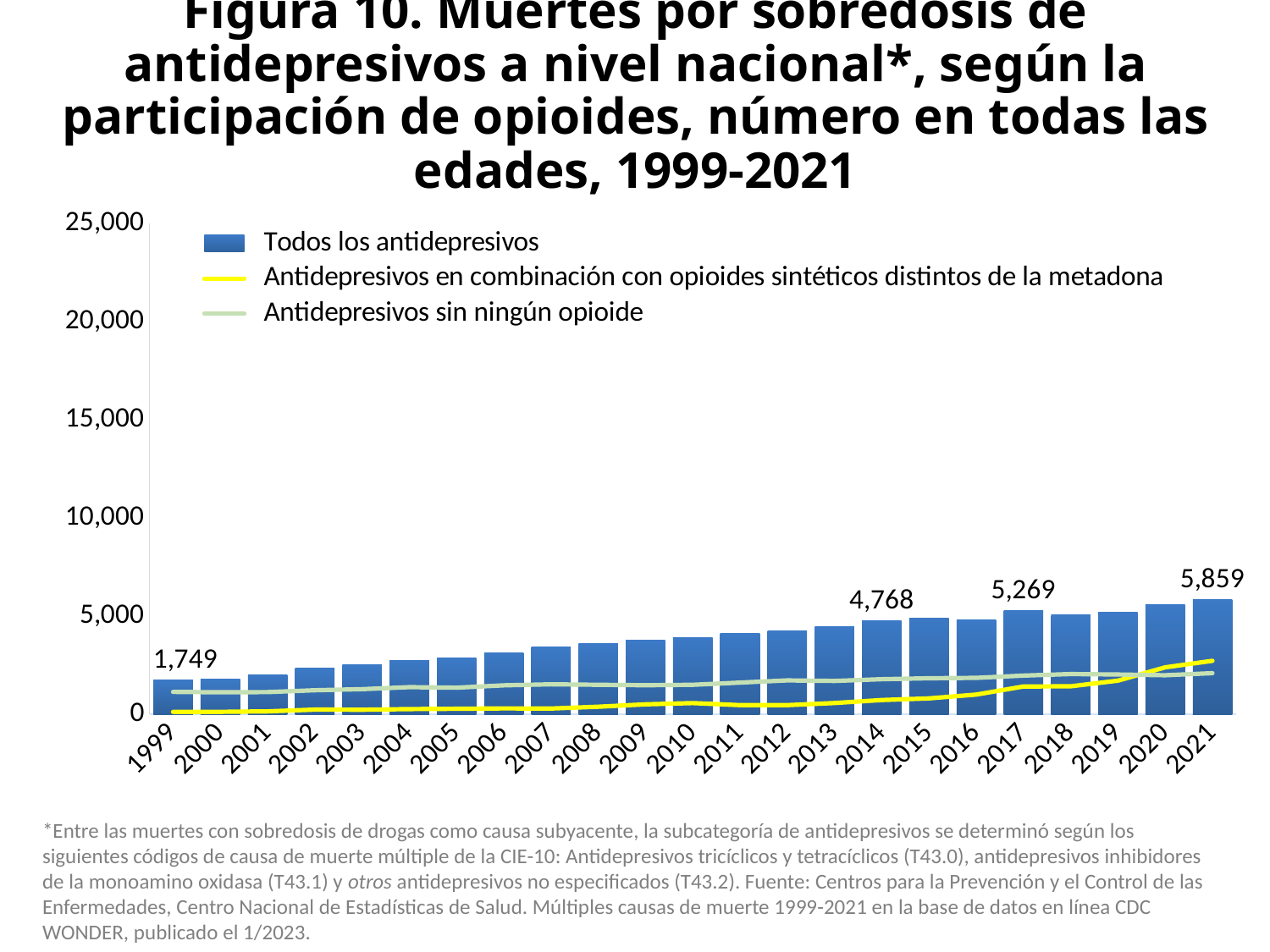
What is the difference between the Todos los antidepresivos values for 2021 and 1999? 4,110 Which series is drawn as a yellow line? Antidepresivos en combinación con opioides sintéticos distintos de la metadona How many years are shown on the x axis? 23 What is the value for Todos los antidepresivos in 2014? 4,768 What is the value for Todos los antidepresivos in 2017? 5,269 Which year has the lowest bar for Todos los antidepresivos? 1999 How many series does the legend list? 3 What is the value for Todos los antidepresivos in 2021? 5,859 Which year has the highest bar for Todos los antidepresivos? 2021 What is the difference between the Todos los antidepresivos values for 2021 and 2017? 590 What is the value for Todos los antidepresivos in 1999? 1,749 Is the value for Todos los antidepresivos in 2010 greater or less than 5,000? less